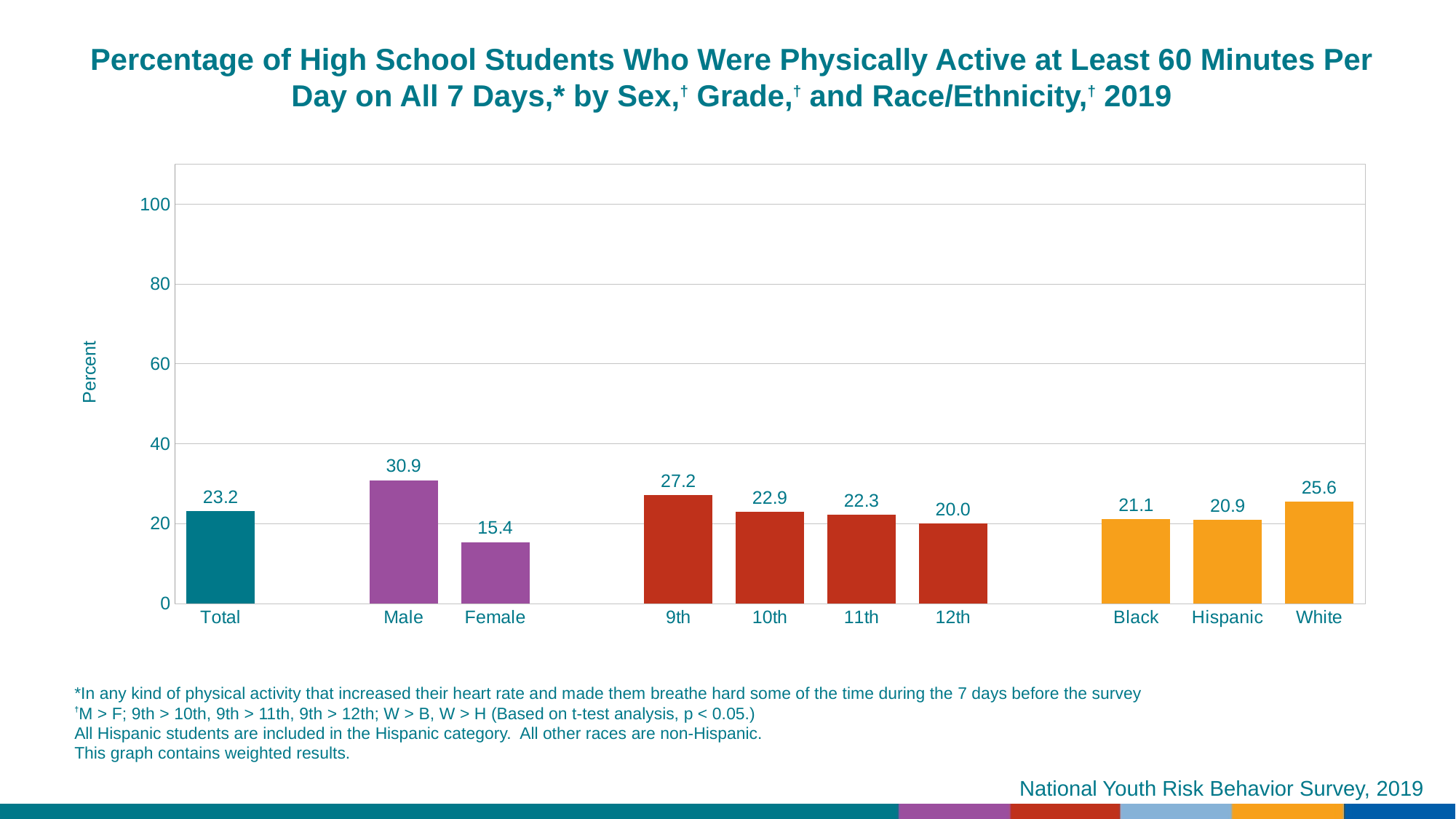
Is the value for White greater or less than 40? less What is the label of the y axis? Percent Do the values rise or fall from 9th grade to 12th grade? fall Which category has the lowest value? Female How many categories are shown on the x axis? 10 What percentage of Male students were physically active at least 60 minutes per day on all 7 days? 30.9 Which is larger, the value for 9th grade or the value for 10th grade? 9th Which category has the highest value? Male What is the value for Total? 23.2 What is the value for 12th grade? 20.0 What kind of chart is this? bar chart What is the difference between the Male and Female values? 15.5